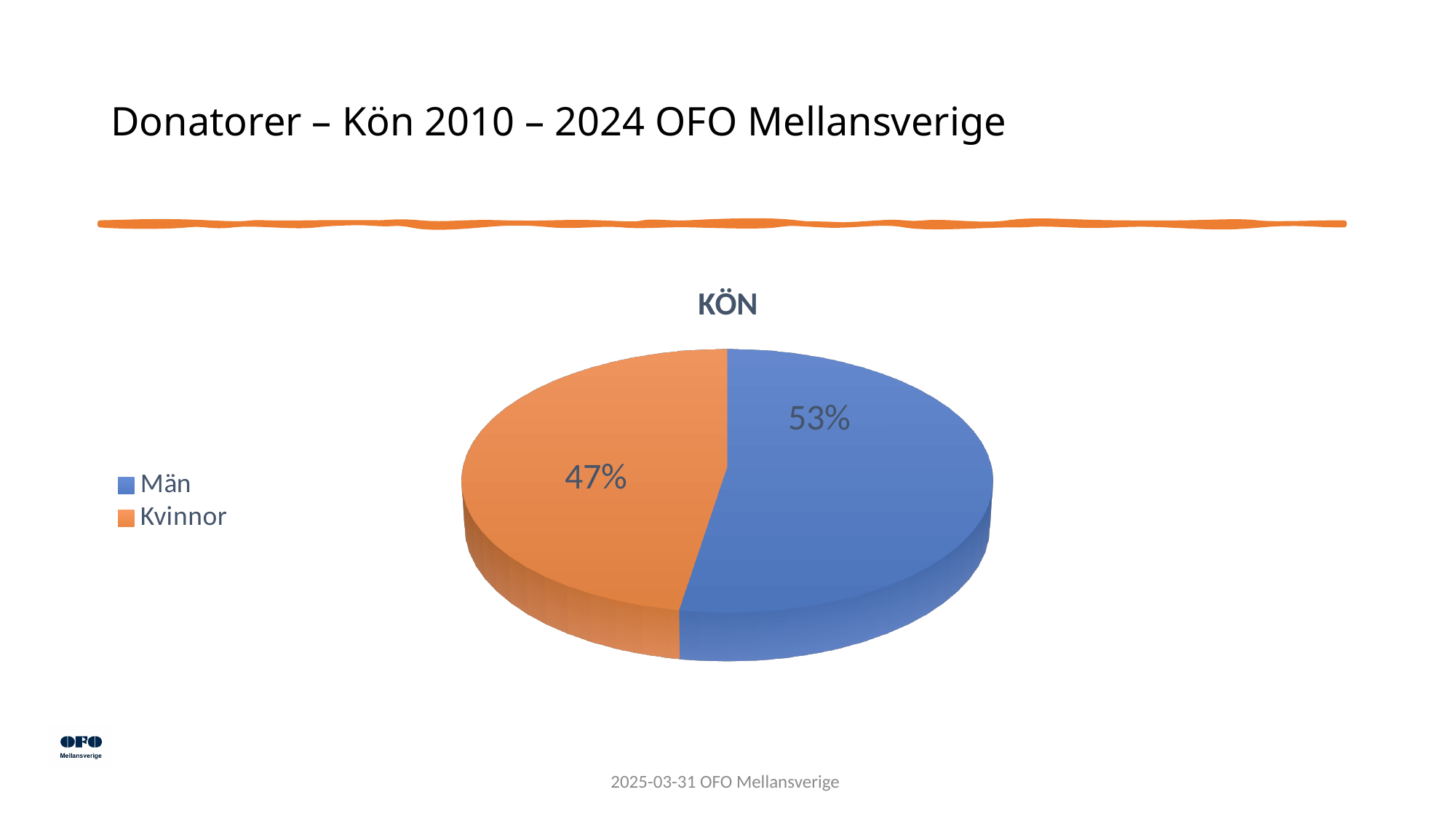
How many categories does the pie chart have? 2 What colour is the Kvinnor slice? orange Which is larger, the share for Män or the share for Kvinnor? Män What is the difference in percentage points between Män and Kvinnor? 6 Which category has the smallest slice of the pie? Kvinnor How many entries does the legend list? 2 Which category has the largest slice of the pie? Män What share of the pie is Män? 53% What type of chart is shown on the slide? pie chart What share of the pie is Kvinnor? 47% What is the title of the chart? KÖN